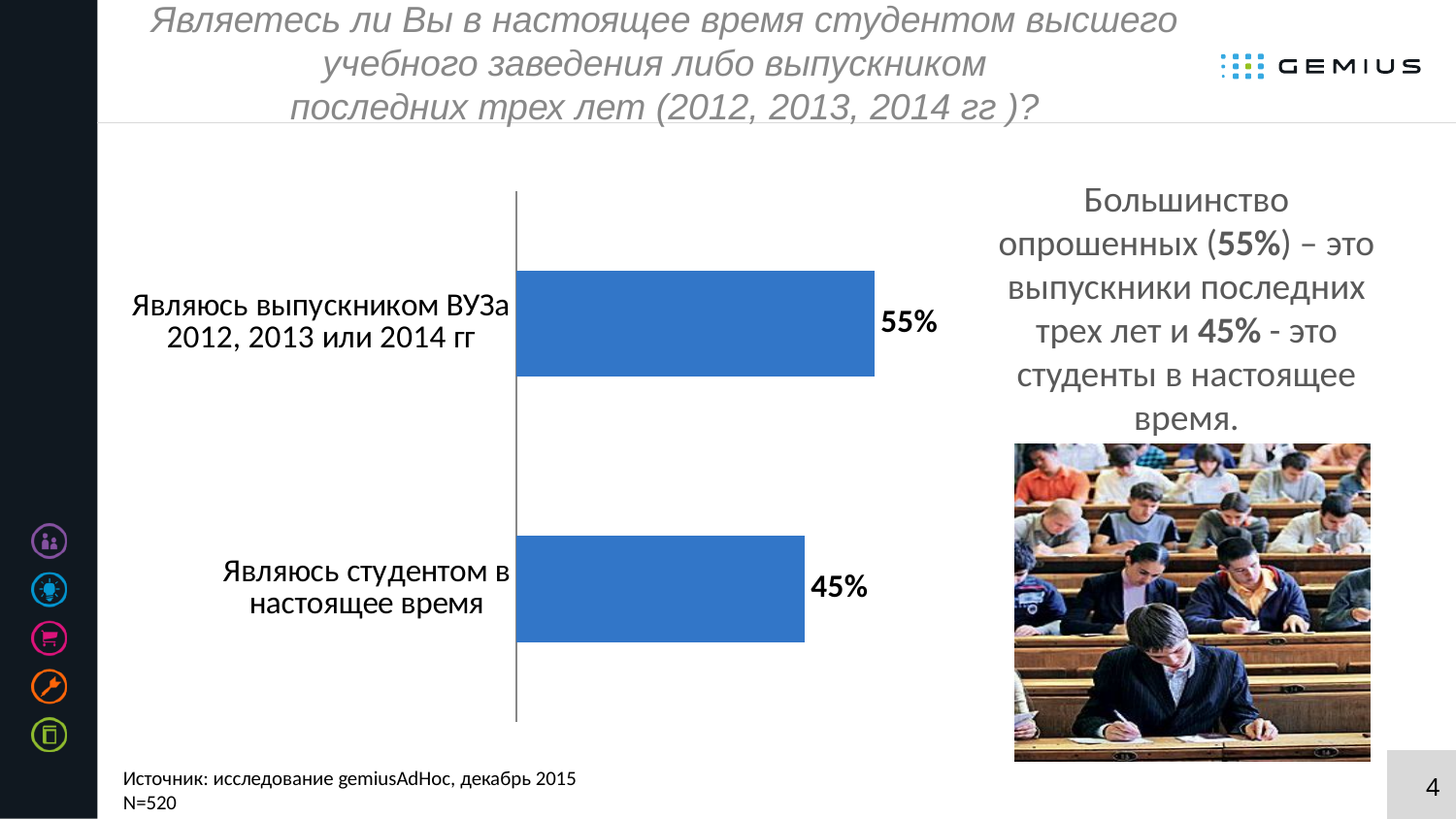
What is the value for "Являюсь выпускником ВУЗа 2012, 2013 или 2014 гг"? 55% What is the sample size (N) stated on the slide? N=520 What is the total of the two values shown in the chart? 100% Which category has the lowest value? Являюсь студентом в настоящее время How many categories are shown in the chart? 2 What is the difference between the values for "Являюсь выпускником ВУЗа 2012, 2013 или 2014 гг" and "Являюсь студентом в настоящее время"? 10% What colour are the bars in the chart? Blue What is the value for "Являюсь студентом в настоящее время"? 45% Which category has the highest value? Являюсь выпускником ВУЗа 2012, 2013 или 2014 гг What kind of chart is shown on the slide? Bar chart Which is larger: the value for "Являюсь выпускником ВУЗа 2012, 2013 или 2014 гг" or for "Являюсь студентом в настоящее время"? Являюсь выпускником ВУЗа 2012, 2013 или 2014 гг